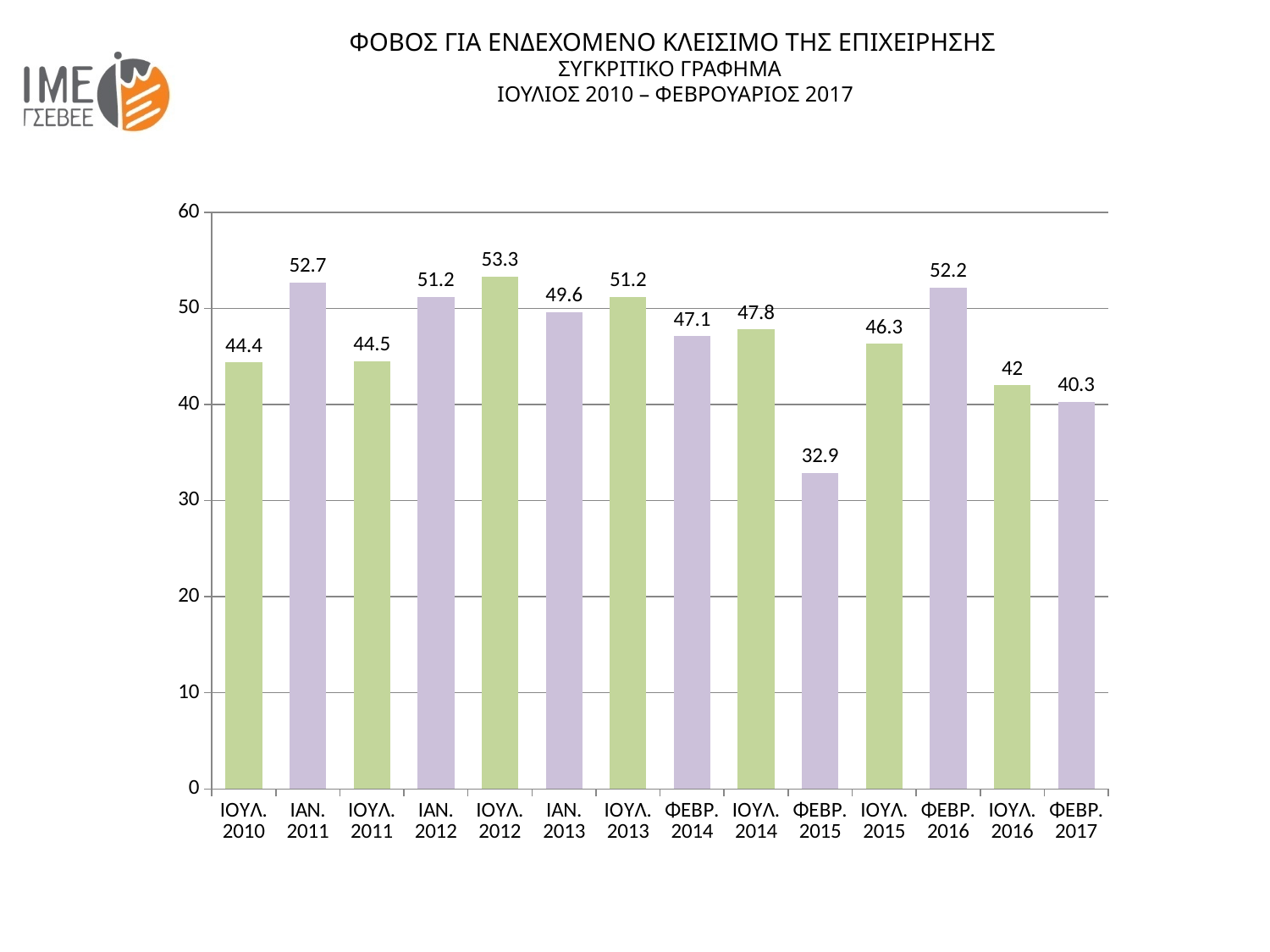
What is the maximum value shown on the y axis? 60 What kind of chart is shown on the slide? bar chart How many periods are shown on the x axis? 14 What is the value for ΙΟΥΛ. 2010? 44.4 Is the value for ΙΑΝ. 2013 greater or less than 40? greater What is the difference between the values for ΙΑΝ. 2011 and ΙΟΥΛ. 2010? 8.3 Which period has the highest value? ΙΟΥΛ. 2012 What is the value for ΦΕΒΡ. 2015? 32.9 What is the value for ΦΕΒΡ. 2017? 40.3 Do the values rise or fall from ΦΕΒΡ. 2016 to ΦΕΒΡ. 2017? fall Which period has the lowest value? ΦΕΒΡ. 2015 Which is larger, the value for ΦΕΒΡ. 2016 or the value for ΙΟΥΛ. 2016? ΦΕΒΡ. 2016